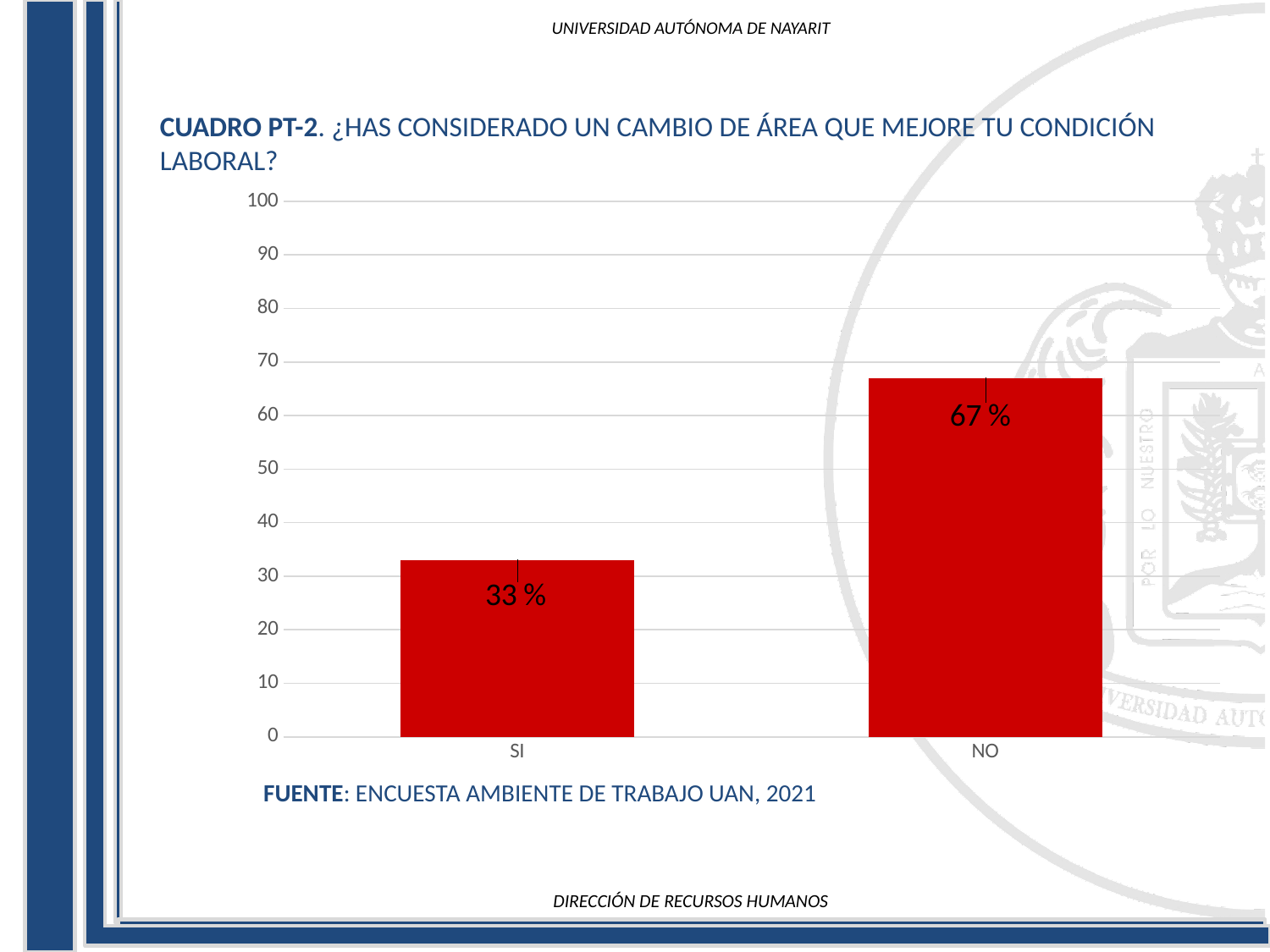
What is the maximum value shown on the y axis? 100 Is the value for NO greater or less than 60? greater What source is cited below the chart? ENCUESTA AMBIENTE DE TRABAJO UAN, 2021 Is the value for SI greater or less than 40? less What kind of chart is shown on the slide? bar chart Which category has the highest value? NO Which is larger, the value for SI or the value for NO? NO What is the value for NO? 67 % Which category has the lowest value? SI What is the value for SI? 33 % How many categories are shown on the x axis? 2 What is the difference between the values for NO and SI? 34 %